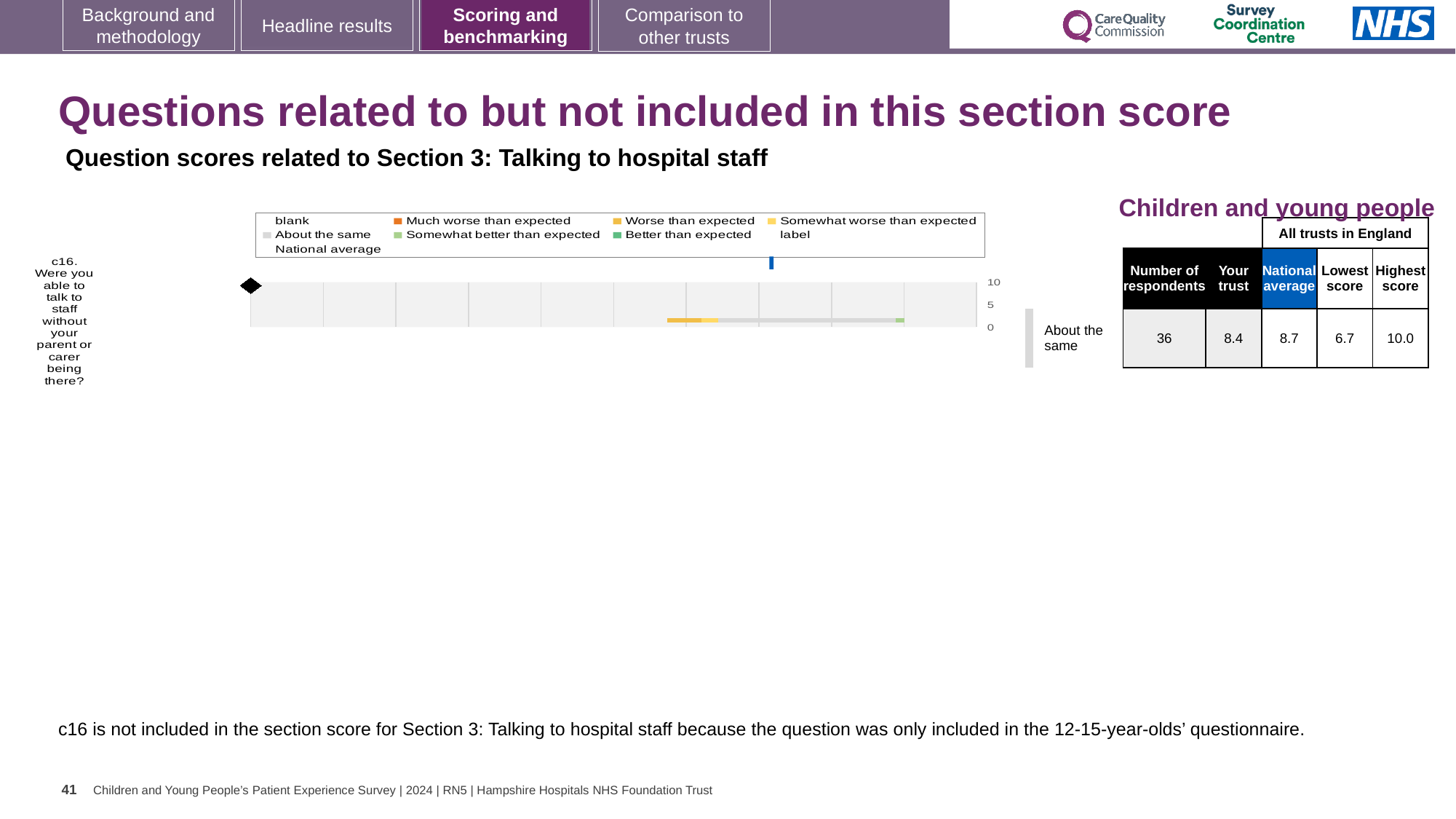
Which section do the question scores in the chart relate to? Section 3: Talking to hospital staff What colour is the 'Much worse than expected' legend entry in the chart? orange What is the highest tick value shown on the chart's axis? 10 How many question categories are plotted in the chart? 1 How many entries does the chart's legend list? 9 What kind of chart is shown for question c16 on the slide? bar chart Which question is plotted in the chart? c16. Were you able to talk to staff without your parent or carer being there?